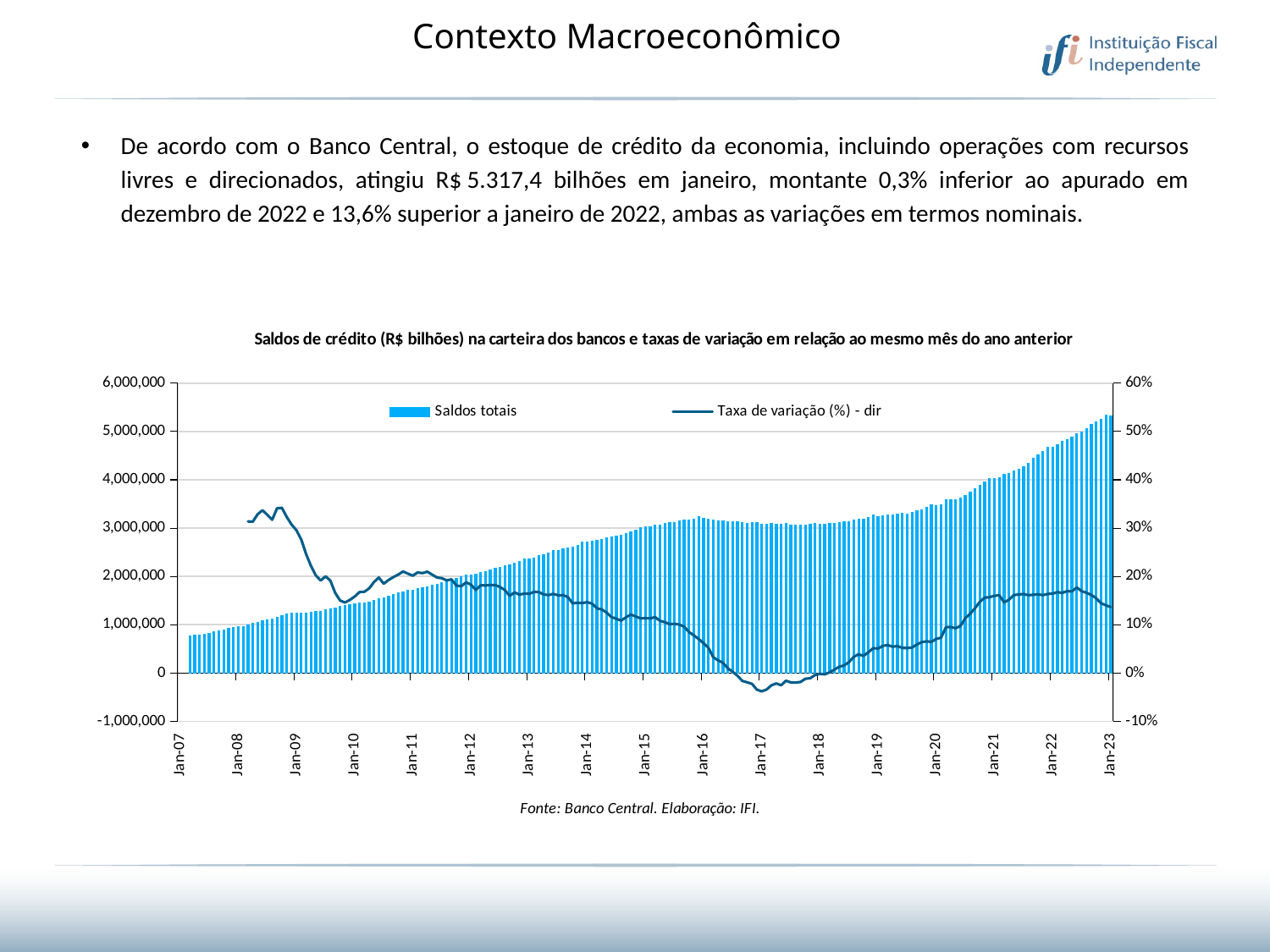
Is the Saldos totais value at Jan-23 greater or less than 5,000,000? greater Which series is plotted as bars in the chart? Saldos totais What kind of chart is shown on the slide? A combined bar and line chart Is the Saldos totais value at Jan-07 greater or less than 1,000,000? less At which labelled date on the x axis is the Saldos totais bar highest? Jan-23 How many series does the chart legend list? 2 Does the Taxa de variação line rise or fall between Jan-08 and Jan-17? Fall At which labelled date on the x axis is the Saldos totais bar lowest? Jan-07 Is the Saldos totais bar larger at Jan-22 or at Jan-12? Jan-22 Is the Taxa de variação value at Jan-17 greater or less than 0%? less Do the Saldos totais bars generally rise or fall from Jan-07 to Jan-23? Rise Which series is plotted against the right-hand axis? Taxa de variação (%) - dir